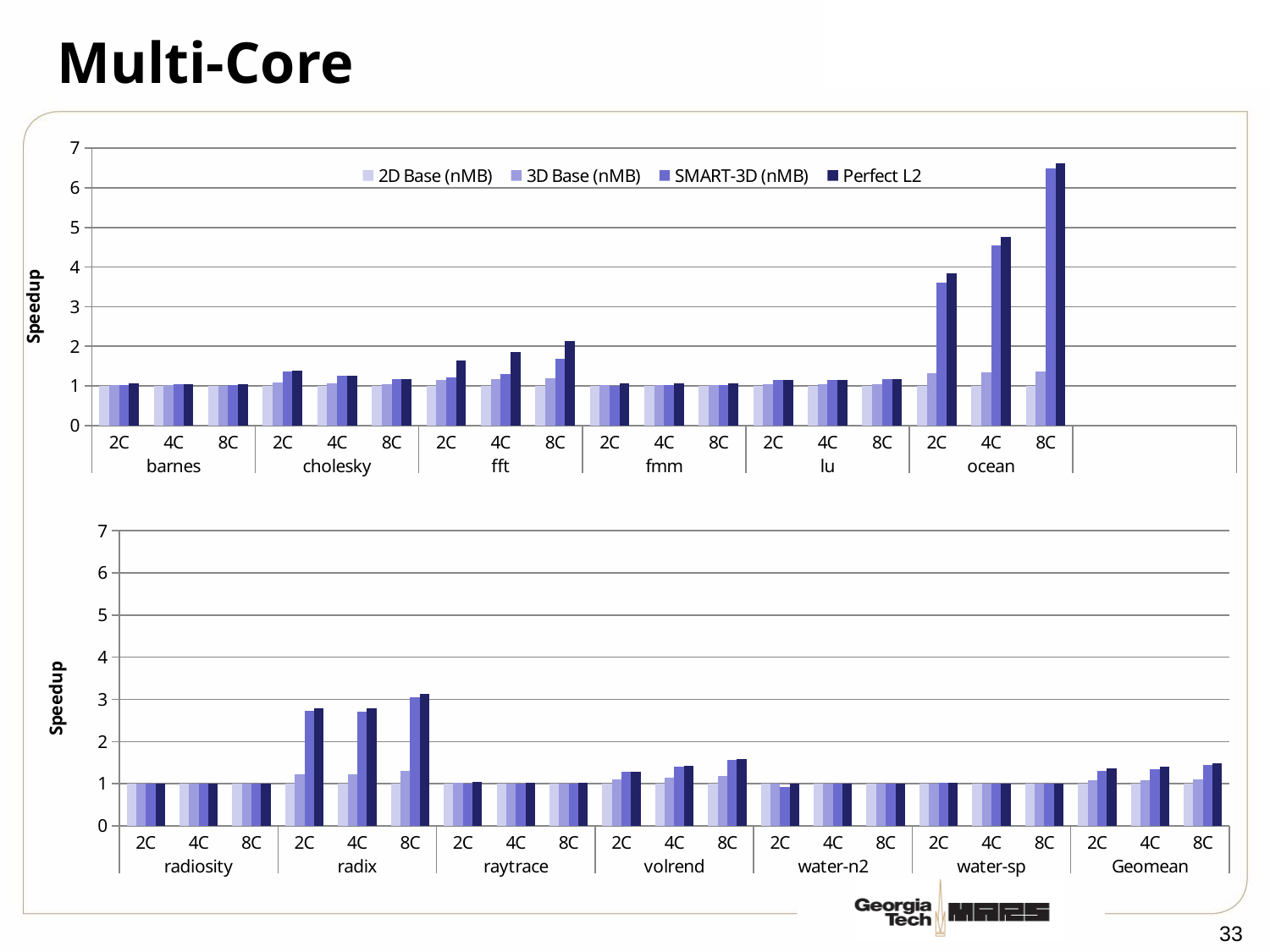
In the top chart, which benchmark has the tallest bar? ocean In the top chart, how many benchmark groups are shown along the x axis? 6 In the top chart, is the Perfect L2 value for ocean at 8C greater or less than 6? greater What kind of chart is the top chart on the slide? bar chart How many series does the legend of the top chart list? 4 In the bottom chart, which benchmark has the tallest bars? radix In the bottom chart, is the Perfect L2 value for radix at 2C greater or less than 3? less In the bottom chart, is the Perfect L2 value for volrend at 8C greater or less than 2? less In the bottom chart, how many benchmark groups are shown along the x axis? 7 In the top chart, which is larger: the SMART-3D (nMB) value for ocean at 4C or for fft at 4C? ocean at 4C What is the label on the y axis of the bottom chart? Speedup